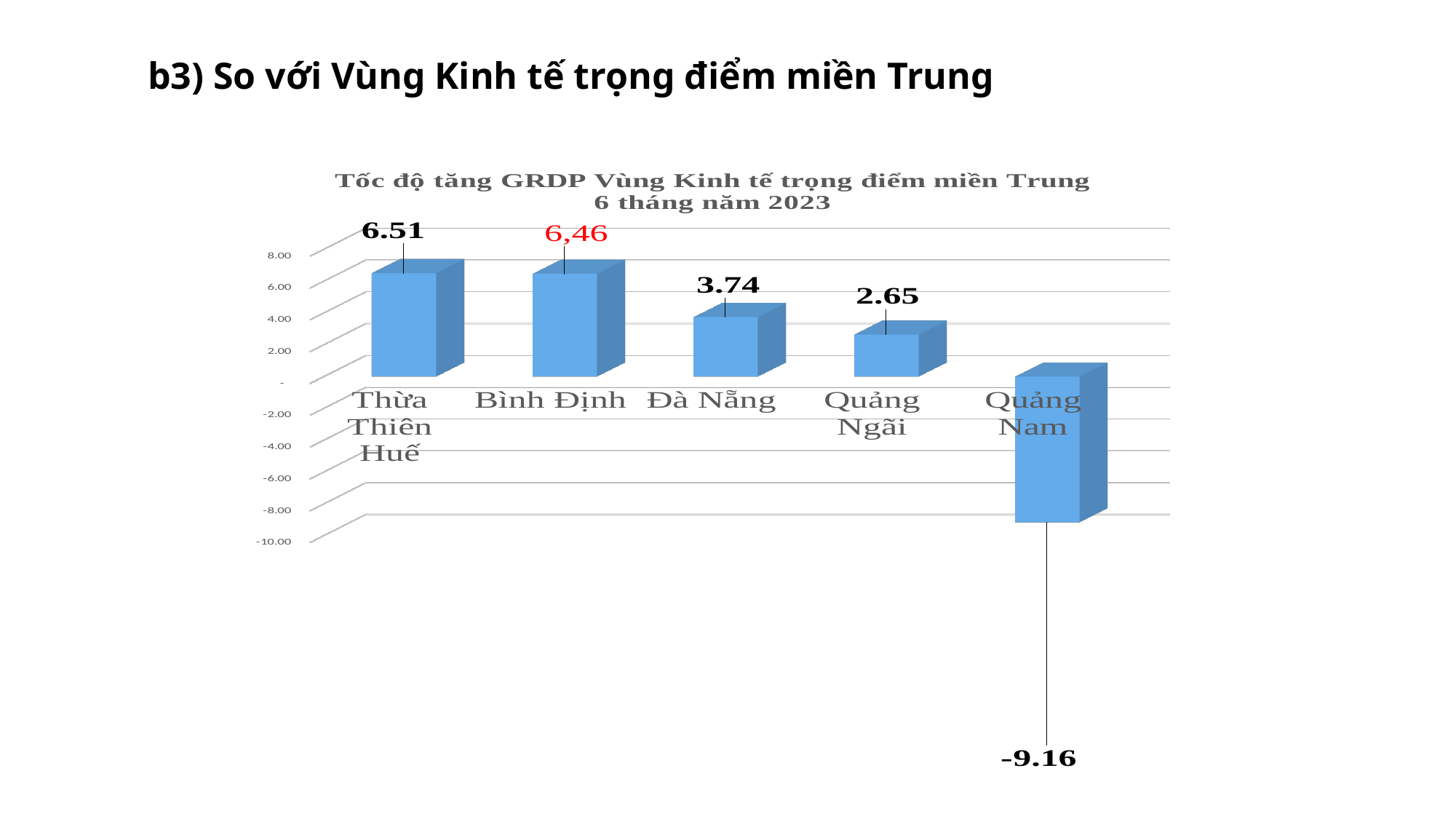
What is the difference between the values for Thừa Thiên Huế and Đà Nẵng? 2.77 Which province has the lowest value in the chart? Quảng Nam Which has a larger value, Quảng Ngãi or Đà Nẵng? Đà Nẵng What kind of chart is shown on the slide? Bar chart How many provinces are shown in the chart? 5 What is the value shown for Đà Nẵng? 3.74 What is the GRDP growth rate shown for Thừa Thiên Huế? 6.51 Which province has the highest GRDP growth rate in the chart? Thừa Thiên Huế What is the difference between the values for Đà Nẵng and Quảng Ngãi? 1.09 What value is labelled on the bar for Bình Định? 6,46 What is the title of the chart? Tốc độ tăng GRDP Vùng Kinh tế trọng điểm miền Trung 6 tháng năm 2023 What is the value shown for Quảng Nam? -9.16